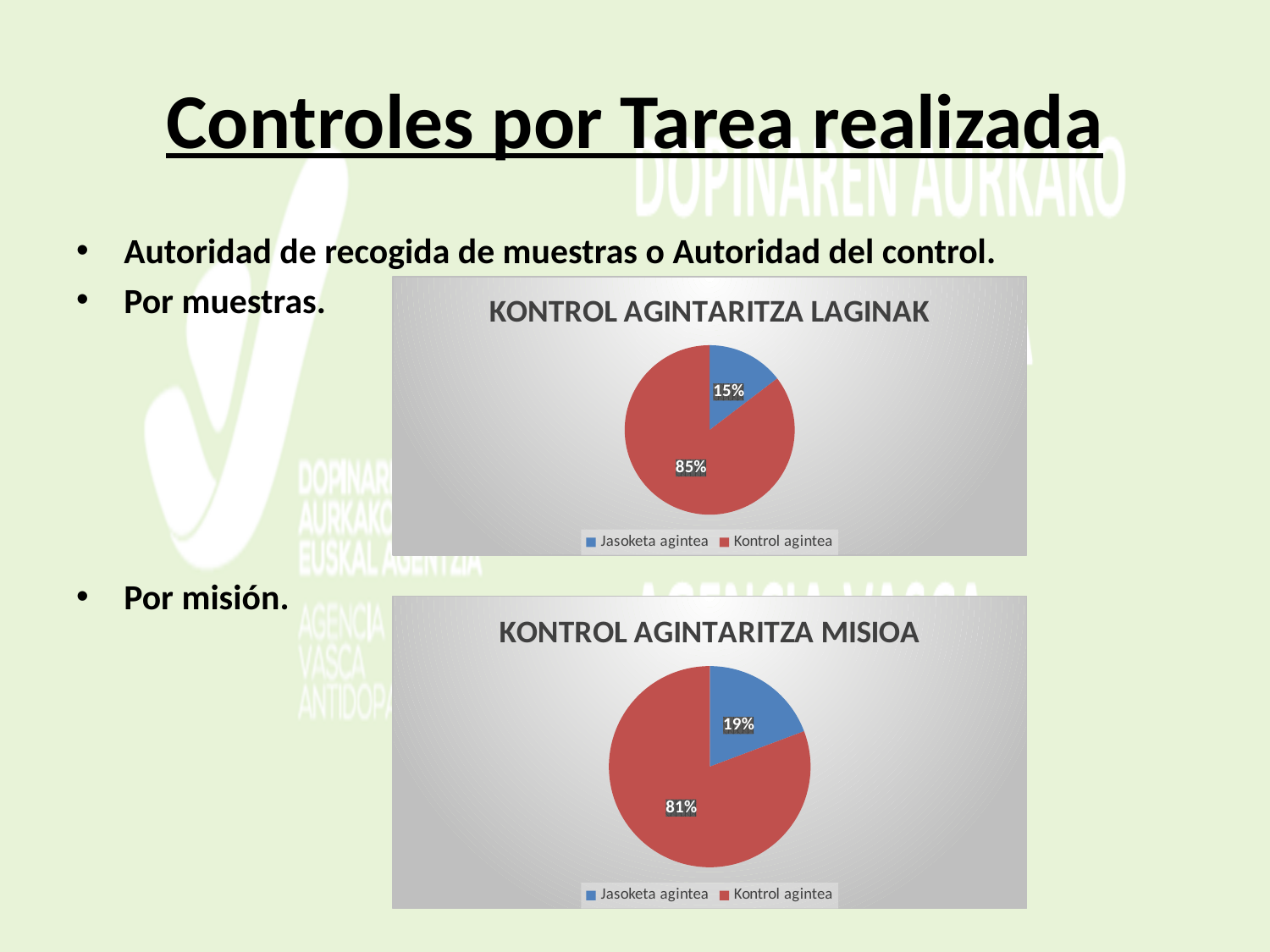
In the chart titled "KONTROL AGINTARITZA MISIOA", what colour is the Kontrol agintea slice? Red In the chart titled "KONTROL AGINTARITZA MISIOA", what share of the pie is Kontrol agintea? 81% In the chart titled "KONTROL AGINTARITZA LAGINAK", what share of the pie is Kontrol agintea? 85% In the chart titled "KONTROL AGINTARITZA MISIOA", which category has the smallest slice? Jasoketa agintea Which is larger: the Jasoketa agintea share in the "KONTROL AGINTARITZA LAGINAK" chart or in the "KONTROL AGINTARITZA MISIOA" chart? KONTROL AGINTARITZA MISIOA In the chart titled "KONTROL AGINTARITZA LAGINAK", what share of the pie is Jasoketa agintea? 15% How many categories does the legend of the chart titled "KONTROL AGINTARITZA LAGINAK" list? 2 In the chart titled "KONTROL AGINTARITZA LAGINAK", which category has the largest slice? Kontrol agintea What kind of chart is the chart titled "KONTROL AGINTARITZA MISIOA"? Pie chart In the chart titled "KONTROL AGINTARITZA LAGINAK", what is the difference in percentage points between Kontrol agintea and Jasoketa agintea? 70 In the chart titled "KONTROL AGINTARITZA MISIOA", what is the difference in percentage points between Kontrol agintea and Jasoketa agintea? 62